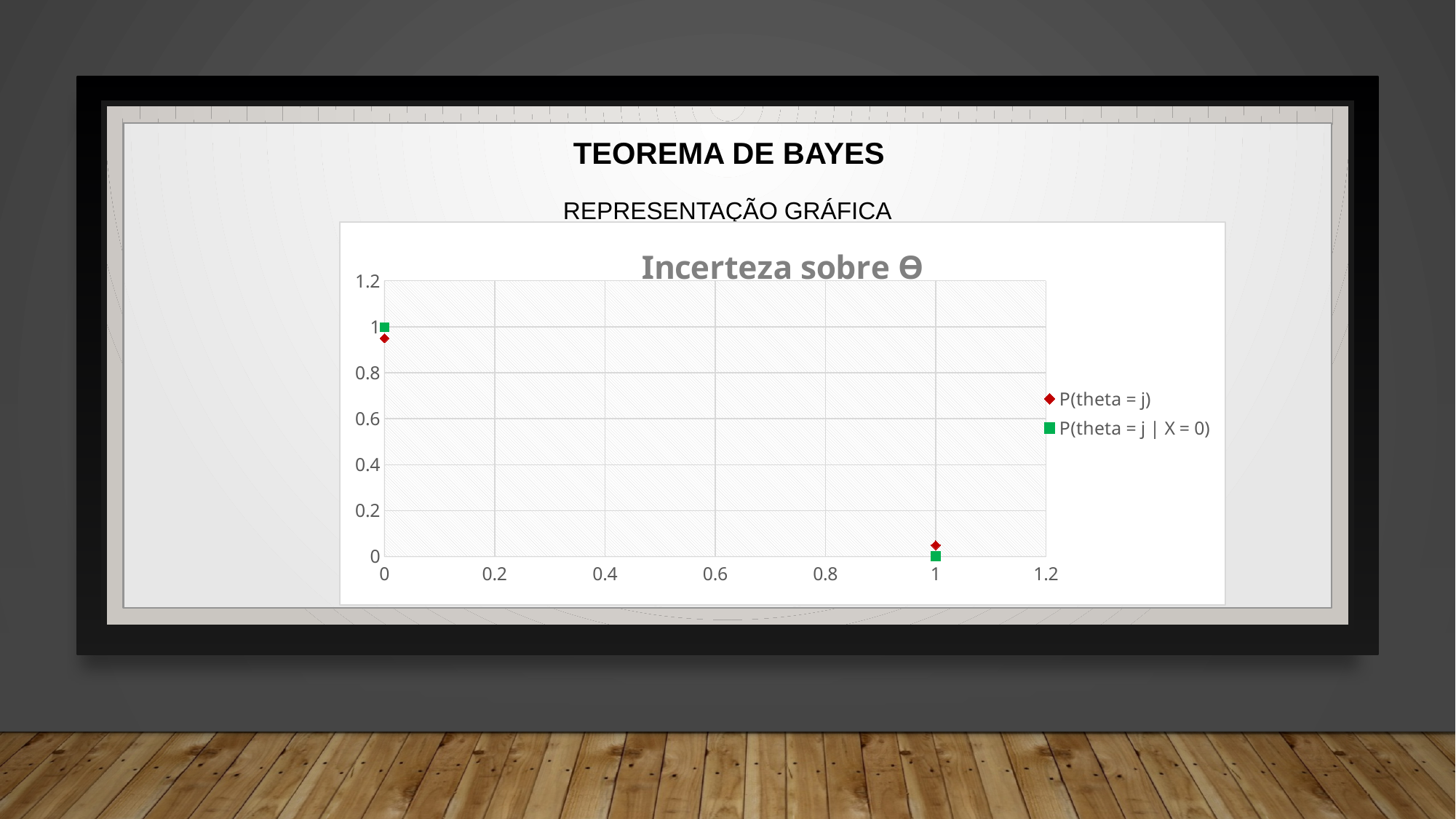
Which series is drawn with green square markers? P(theta = j | X = 0) Is the value of P(theta = j) at x = 0 greater or less than 0.8? greater How many series does the chart legend list? 2 Is the value of P(theta = j | X = 0) at x = 0 greater or less than 0.6? greater Is the value of P(theta = j) at x = 1 greater or less than 0.2? less Do the values of P(theta = j) rise or fall from x = 0 to x = 1? fall How many data points does the P(theta = j) series have? 2 What kind of chart is shown on the slide? scatter chart What is the title of the chart? Incerteza sobre Θ At x = 1, which series has the larger value, P(theta = j) or P(theta = j | X = 0)? P(theta = j)